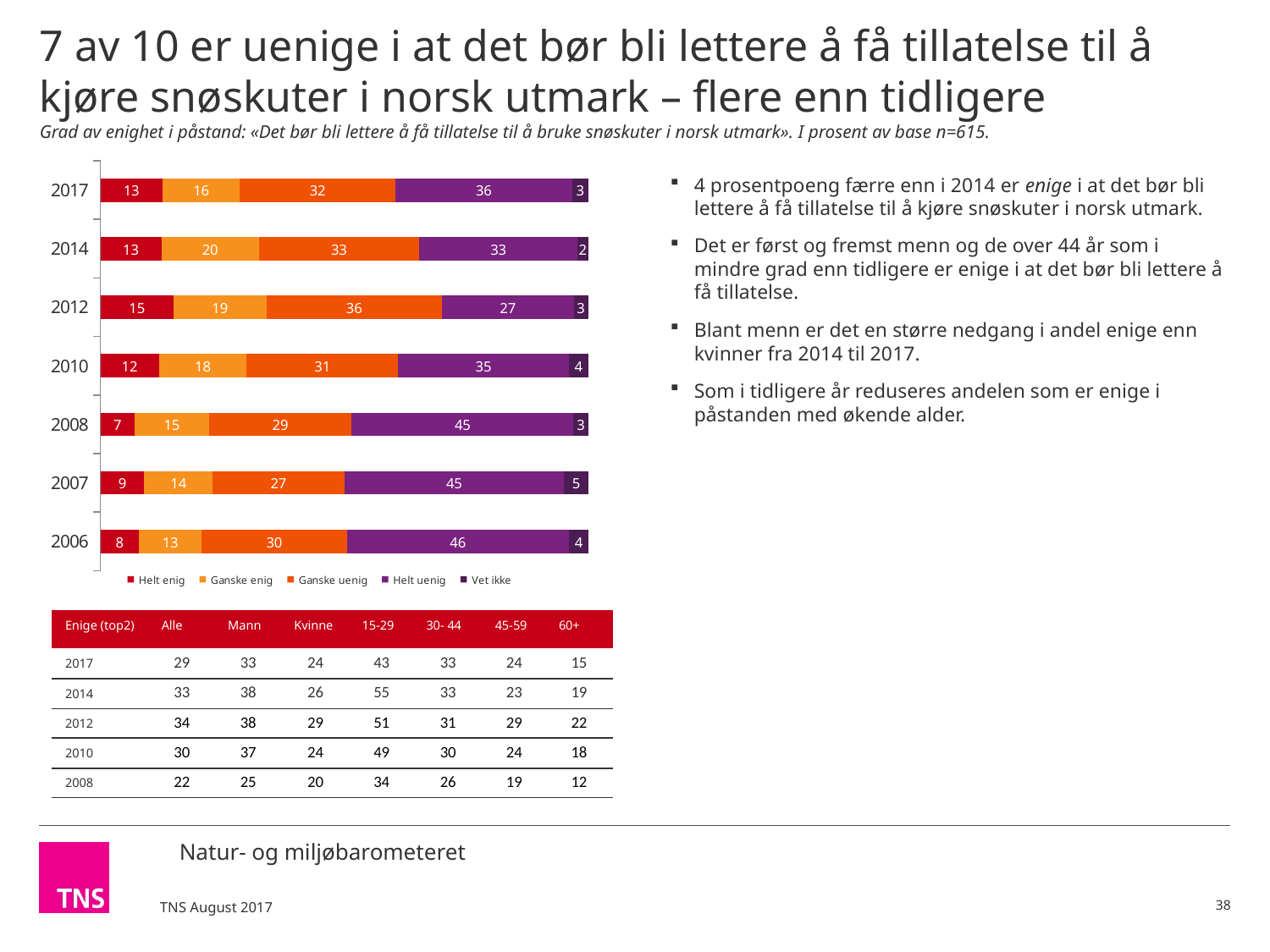
What kind of chart is shown on the slide? Stacked bar chart Which year has the larger "Helt enig" value, 2012 or 2010? 2012 Which series is listed first in the chart legend? Helt enig What is the difference between the "Ganske uenig" values for 2012 and 2017? 4 How many series does the chart legend list? 5 In which year is the "Helt enig" value lowest? 2008 What is the value for "Ganske enig" in 2014? 20 What is the total of the stacked bar for 2017? 100 How many years are shown in the bar chart? 7 What is the value for "Helt enig" in 2008? 7 In which year is the "Helt uenig" value highest? 2006 What is the value for "Helt uenig" in 2017? 36